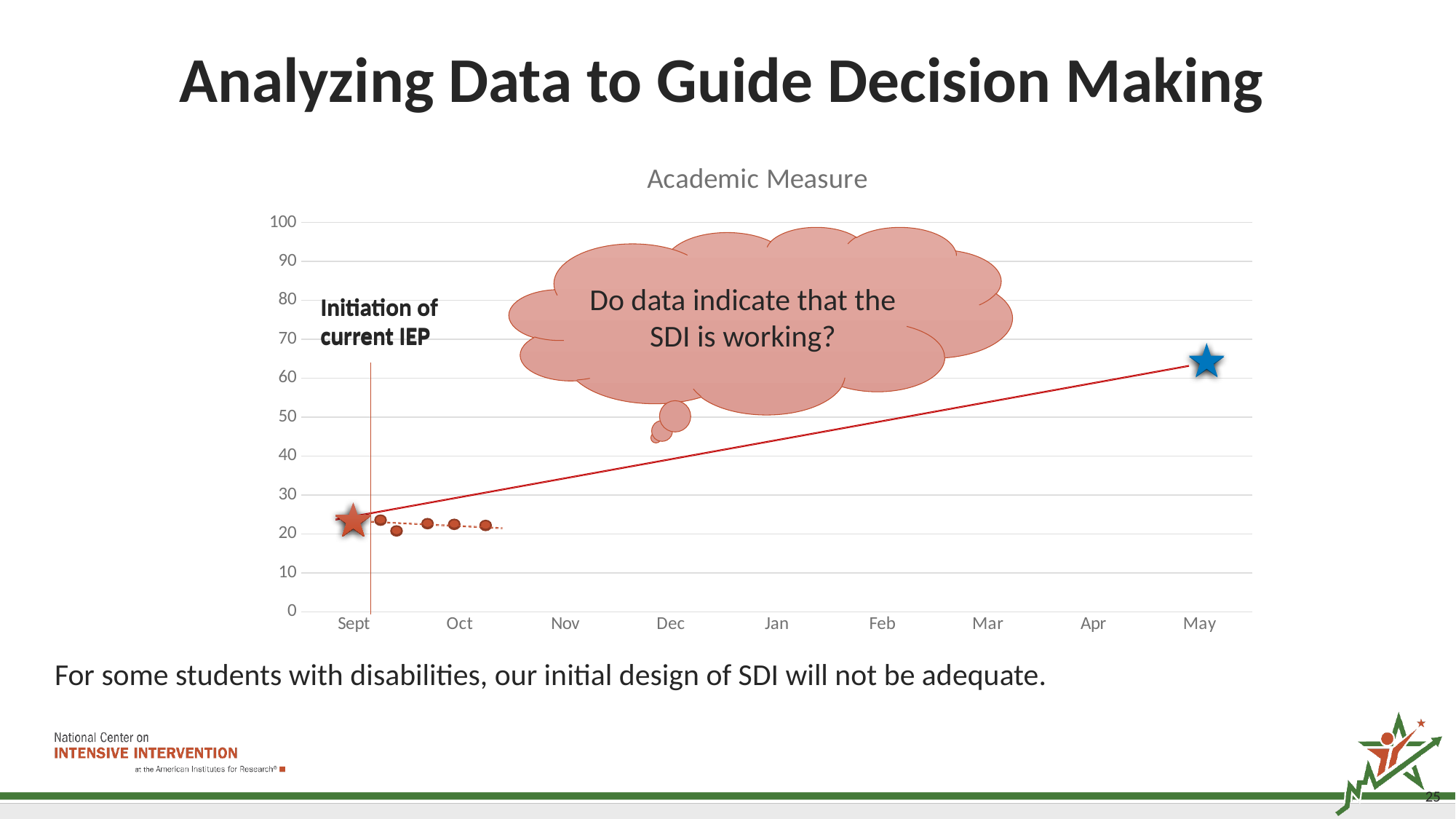
Is the value of the blue star at May greater or less than 70? less What kind of chart is shown on the slide? line chart Does the solid red line from Sept to May rise or fall along the x axis? rise Which month is the first label on the x axis of the chart? Sept Are the plotted data points between Sept and Oct greater or less than 30? less What is the title of the chart? Academic Measure What question is written in the thought bubble on the chart? Do data indicate that the SDI is working? How many months are labeled along the x axis of the chart? 9 Which is larger, the value of the blue star at May or the value of the red star at Sept? the blue star at May Is the value of the blue star at May greater or less than 50? greater